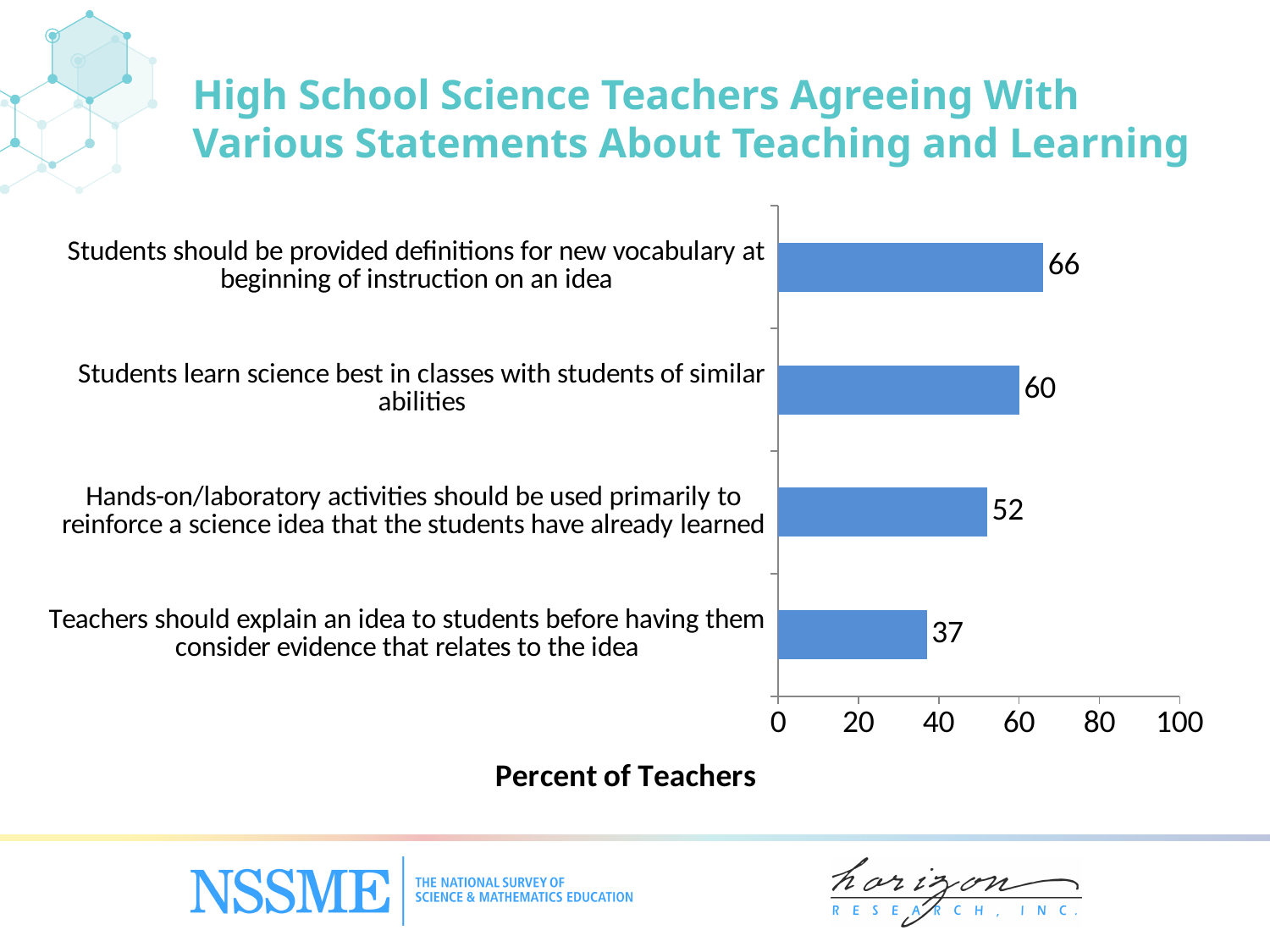
Which has a higher percent of teachers agreeing: the statement about similar abilities or the statement about hands-on/laboratory activities? Students learn science best in classes with students of similar abilities What is the difference in percent of teachers between the statement about similar abilities and the statement about hands-on/laboratory activities? 8 How many statements are shown in the chart? 4 What percent of high school science teachers agree that students should be provided definitions for new vocabulary at beginning of instruction on an idea? 66 What is the difference in percent of teachers between the statement about providing vocabulary definitions and the statement about explaining an idea before considering evidence? 29 What kind of chart is shown on the slide? Bar chart Which statement has the highest percent of teachers agreeing? Students should be provided definitions for new vocabulary at beginning of instruction on an idea What percent of teachers agree that hands-on/laboratory activities should be used primarily to reinforce a science idea that the students have already learned? 52 Which statement has the lowest percent of teachers agreeing? Teachers should explain an idea to students before having them consider evidence that relates to the idea What is the label of the horizontal axis? Percent of Teachers What percent of teachers agree that teachers should explain an idea to students before having them consider evidence that relates to the idea? 37 What percent of teachers agree that students learn science best in classes with students of similar abilities? 60